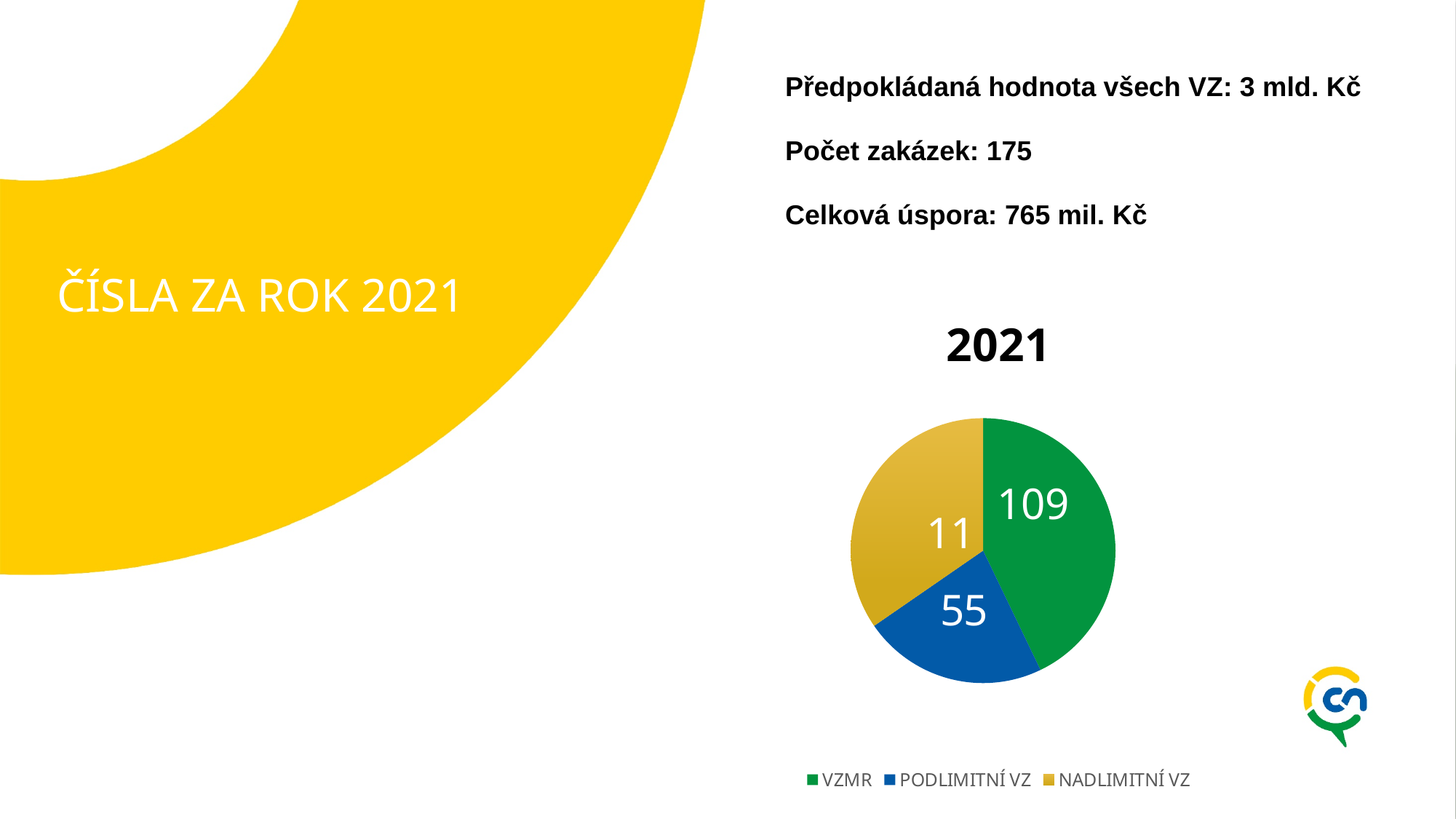
How many slices does the pie chart have? 3 What is the value for PODLIMITNÍ VZ in the pie chart? 55 Which is larger, the value for PODLIMITNÍ VZ or NADLIMITNÍ VZ? PODLIMITNÍ VZ What is the value for VZMR in the pie chart? 109 What is the difference between the values for VZMR and PODLIMITNÍ VZ? 54 Which category has the largest slice in the pie chart? VZMR What is the value for NADLIMITNÍ VZ in the pie chart? 11 Which colour represents PODLIMITNÍ VZ in the pie chart? blue What is the title of the pie chart? 2021 What type of chart is shown on the slide? pie chart What is the total of all slices in the pie chart? 175